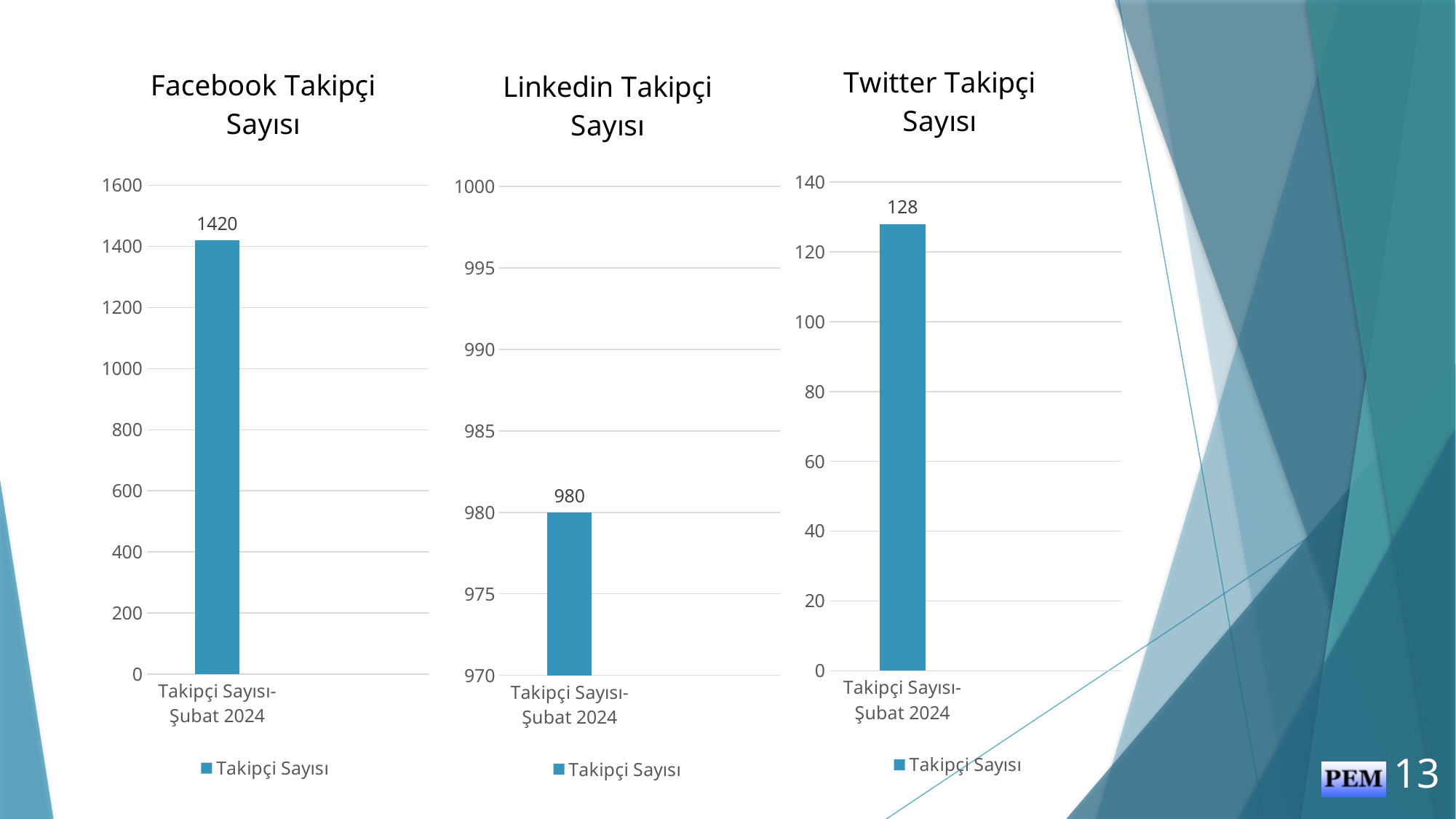
In the 'Facebook Takipçi Sayısı' chart, is the value for Takipçi Sayısı-Şubat 2024 greater or less than 1200? greater In the 'Twitter Takipçi Sayısı' chart, is the value for Takipçi Sayısı-Şubat 2024 greater or less than 140? less How many bars are plotted in the 'Twitter Takipçi Sayısı' chart? 1 What is the difference between the Facebook follower value and the Twitter follower value shown on the slide? 1292 What is the title of the chart on the left of the slide? Facebook Takipçi Sayısı In the 'Facebook Takipçi Sayısı' chart, what is the value for Takipçi Sayısı-Şubat 2024? 1420 In the 'Linkedin Takipçi Sayısı' chart, what is the value for Takipçi Sayısı-Şubat 2024? 980 What is the legend entry in the 'Twitter Takipçi Sayısı' chart? Takipçi Sayısı In the 'Twitter Takipçi Sayısı' chart, what is the value for Takipçi Sayısı-Şubat 2024? 128 What kind of chart is the 'Facebook Takipçi Sayısı' chart? bar chart How many series does the legend of the 'Linkedin Takipçi Sayısı' chart list? 1 Which is larger: the Facebook follower value (1420) or the Linkedin follower value (980)? Facebook (1420)